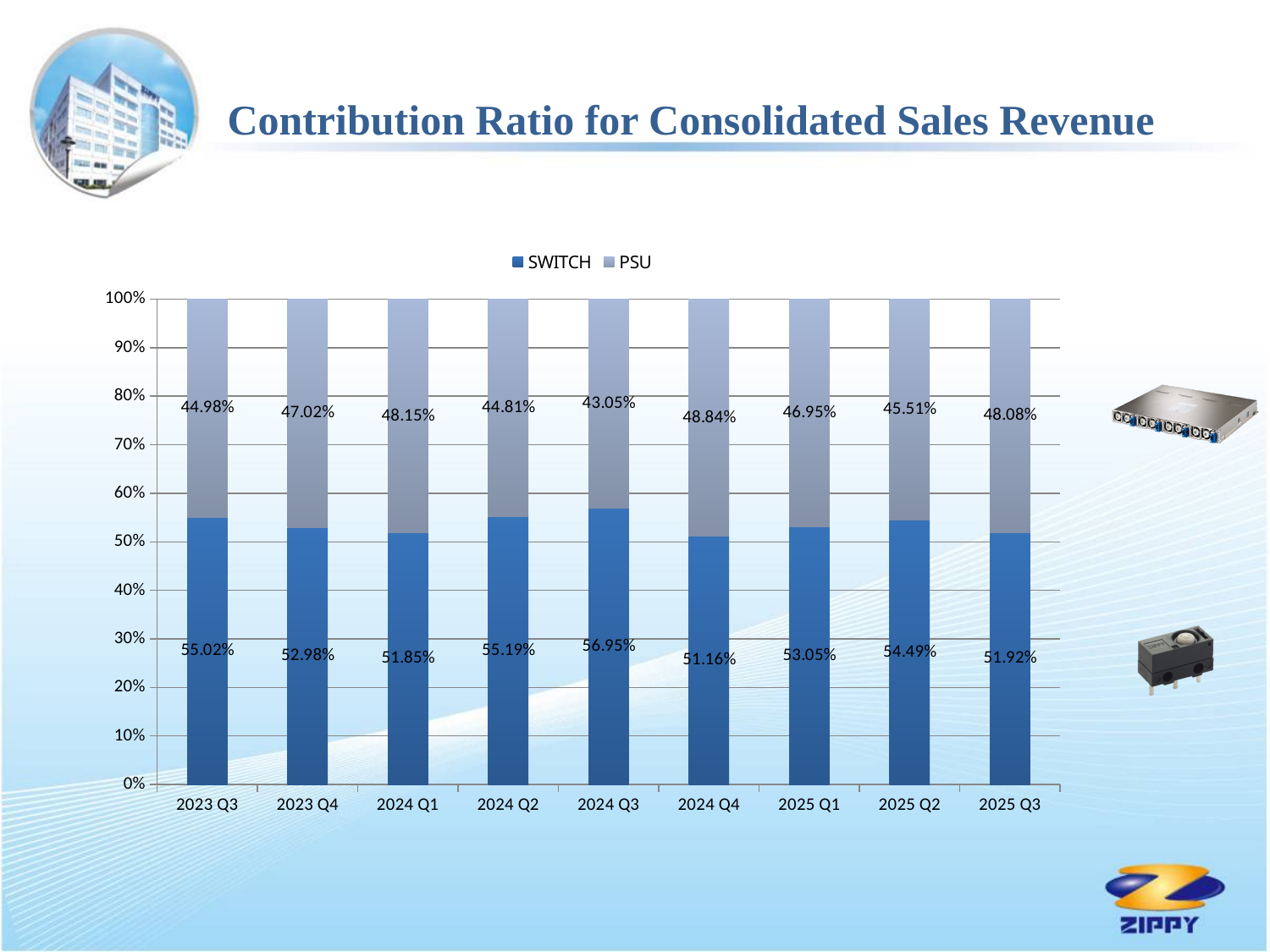
What is the SWITCH contribution ratio for 2024 Q3? 56.95% How many series does the legend list? 2 What is the title of the chart on the slide? Contribution Ratio for Consolidated Sales Revenue In which quarter is the PSU contribution ratio highest? 2024 Q4 What is the difference between the SWITCH and PSU contribution ratios in 2023 Q3? 10.04% In which quarter is the SWITCH contribution ratio lowest? 2024 Q4 What is the SWITCH contribution ratio for 2025 Q3? 51.92% How many quarters are shown on the x axis? 9 What kind of chart is shown on the slide? Stacked bar chart What is the PSU contribution ratio for 2024 Q4? 48.84% Which is larger in 2025 Q2, the SWITCH ratio or the PSU ratio? SWITCH In which quarter is the SWITCH contribution ratio highest? 2024 Q3